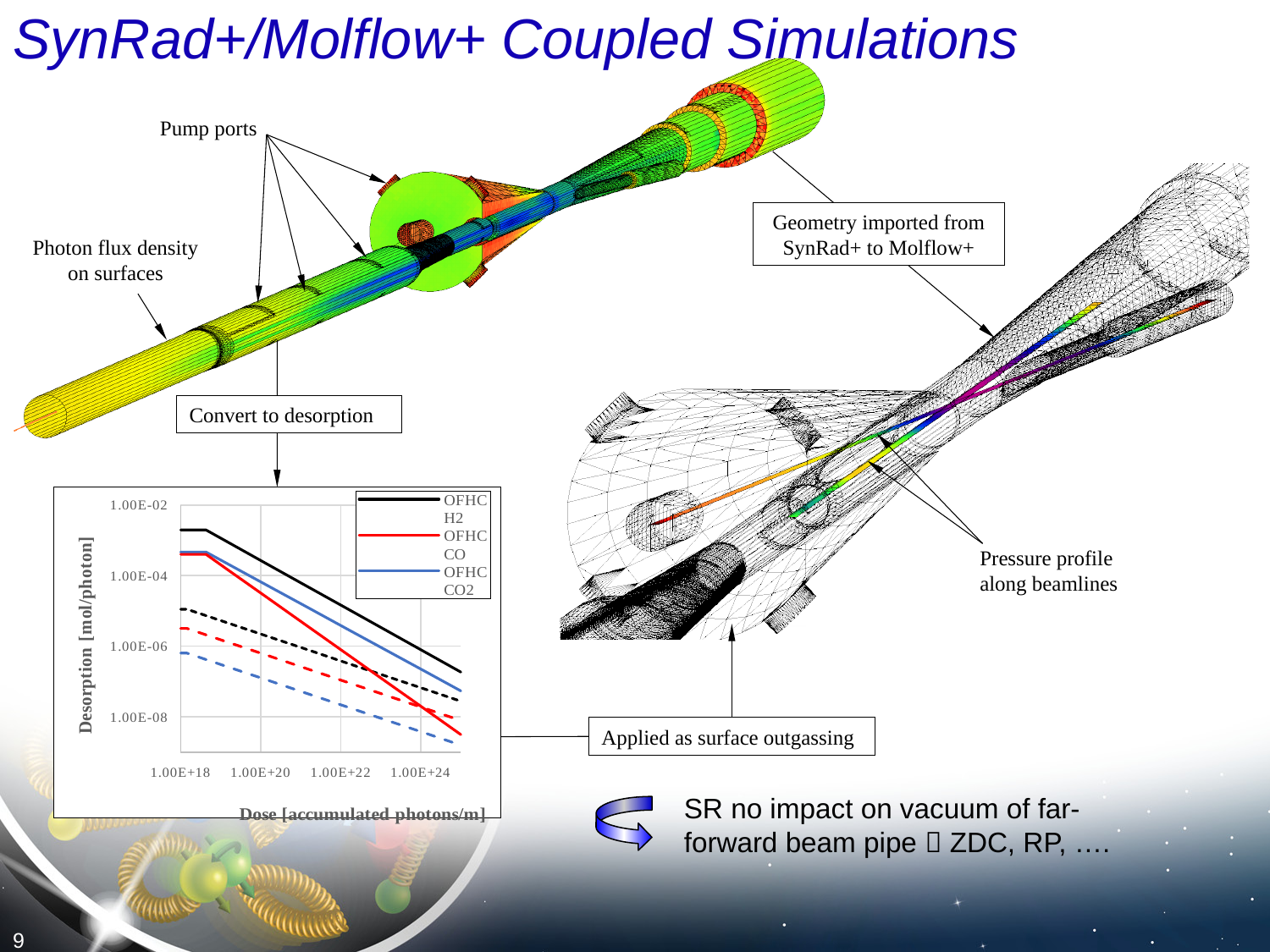
At a dose of 1.00E+22, which is larger: the desorption for OFHC H2 or for OFHC CO? OFHC H2 How many tick labels are shown on the x axis of the chart? 4 Do the desorption values rise or fall as the dose increases along the x axis? fall Is the desorption value for OFHC H2 at a dose of 1.00E+18 greater or less than 1.00E-04? greater Is the desorption value for OFHC CO2 at a dose of 1.00E+24 greater or less than 1.00E-08? greater How many series does the chart legend list? 3 Which series has the highest desorption across the plotted dose range? OFHC H2 What kind of chart is shown on the slide? line chart What is the y-axis title of the chart? Desorption [mol/photon] Is the desorption value for OFHC CO at a dose of 1.00E+22 greater or less than 1.00E-04? less Which series does the legend show in red? OFHC CO